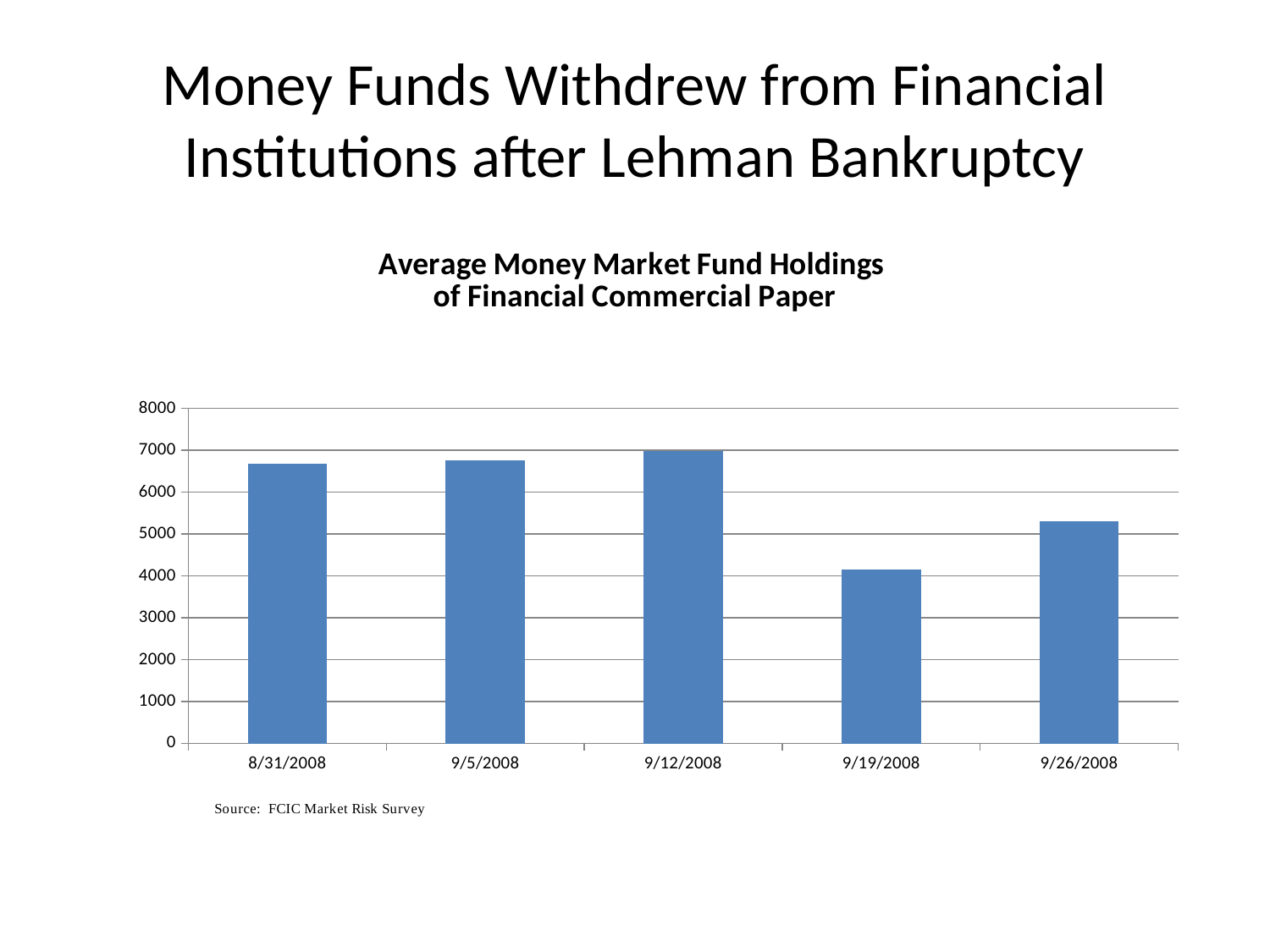
Is the value for 9/26/2008 greater or less than 5000? greater Is the value for 9/19/2008 greater or less than 5000? less Is the value for 8/31/2008 greater or less than 6000? greater Which is larger, the value for 8/31/2008 or the value for 9/19/2008? 8/31/2008 Which date has the lowest average money market fund holdings of financial commercial paper? 9/19/2008 What is the title of the chart? Average Money Market Fund Holdings of Financial Commercial Paper Which date has the highest average money market fund holdings of financial commercial paper? 9/12/2008 Which is larger, the value for 9/26/2008 or the value for 9/19/2008? 9/26/2008 What kind of chart is shown on the slide? bar chart How many dates are plotted on the x axis of the chart? 5 Does the value rise or fall from 9/12/2008 to 9/19/2008? fall